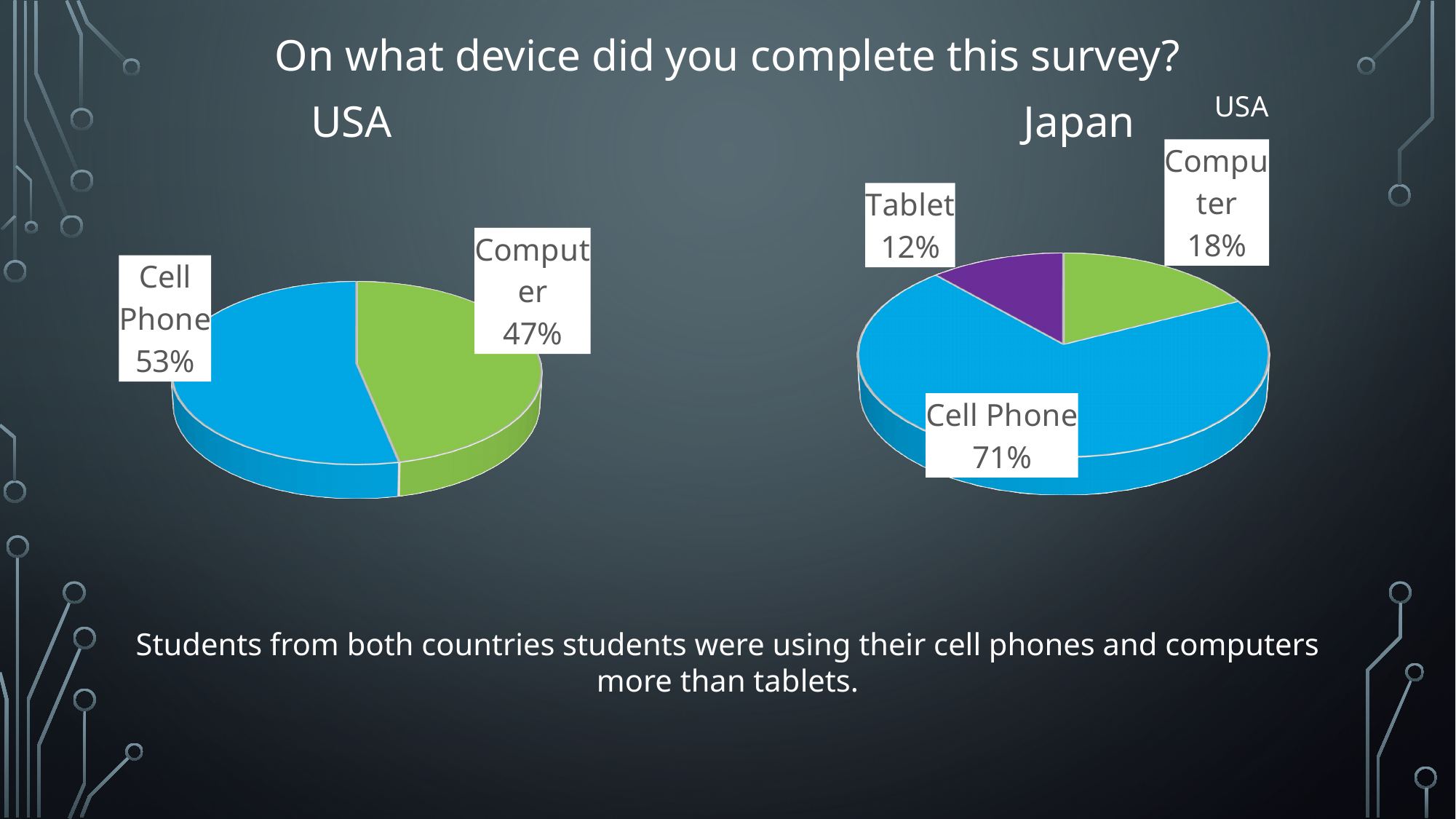
In the USA pie chart, which device has the larger share? Cell Phone In the Japan pie chart, what percentage of students completed the survey on a tablet? 12% What type of chart is used for the USA data? Pie chart In the USA pie chart, what percentage of students completed the survey on a computer? 47% How many slices does the Japan pie chart have? 3 In the Japan pie chart, which device has the smallest share? Tablet In the Japan pie chart, what is the difference between the Cell Phone and Computer shares? 53% In the Japan pie chart, what percentage of students completed the survey on a cell phone? 71% In the Japan pie chart, what percentage of students completed the survey on a computer? 18% In the USA pie chart, what percentage of students completed the survey on a cell phone? 53% In the Japan pie chart, which device has the largest share? Cell Phone In the USA pie chart, what is the difference between the Cell Phone and Computer shares? 6%